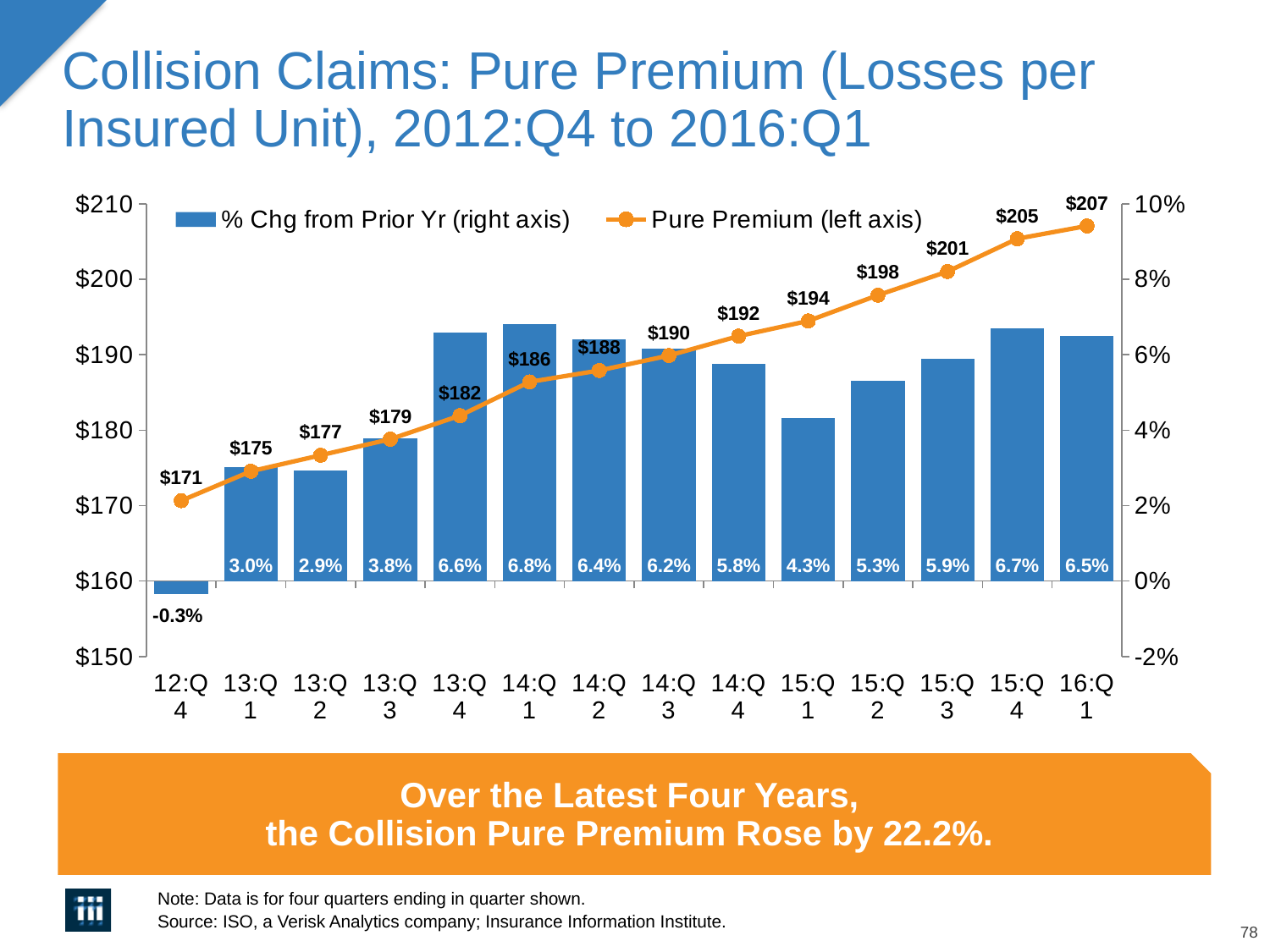
Which quarter has the highest % Chg from Prior Yr? 14:Q1 What is the Pure Premium value for 13:Q4? $182 Which is larger, the % Chg from Prior Yr in 13:Q4 or in 15:Q2? 13:Q4 Which quarter has the lowest % Chg from Prior Yr? 12:Q4 Does the Pure Premium rise or fall from 12:Q4 to 16:Q1? Rise What kind of chart is shown on the slide? Combined bar and line chart What is the Pure Premium value for 16:Q1? $207 What is the difference between the Pure Premium in 16:Q1 and in 12:Q4? $36 Which series is plotted on the right axis according to the legend? % Chg from Prior Yr How many series does the legend list? 2 How many quarters are shown on the x axis? 14 What is the % Chg from Prior Yr for 15:Q1? 4.3%